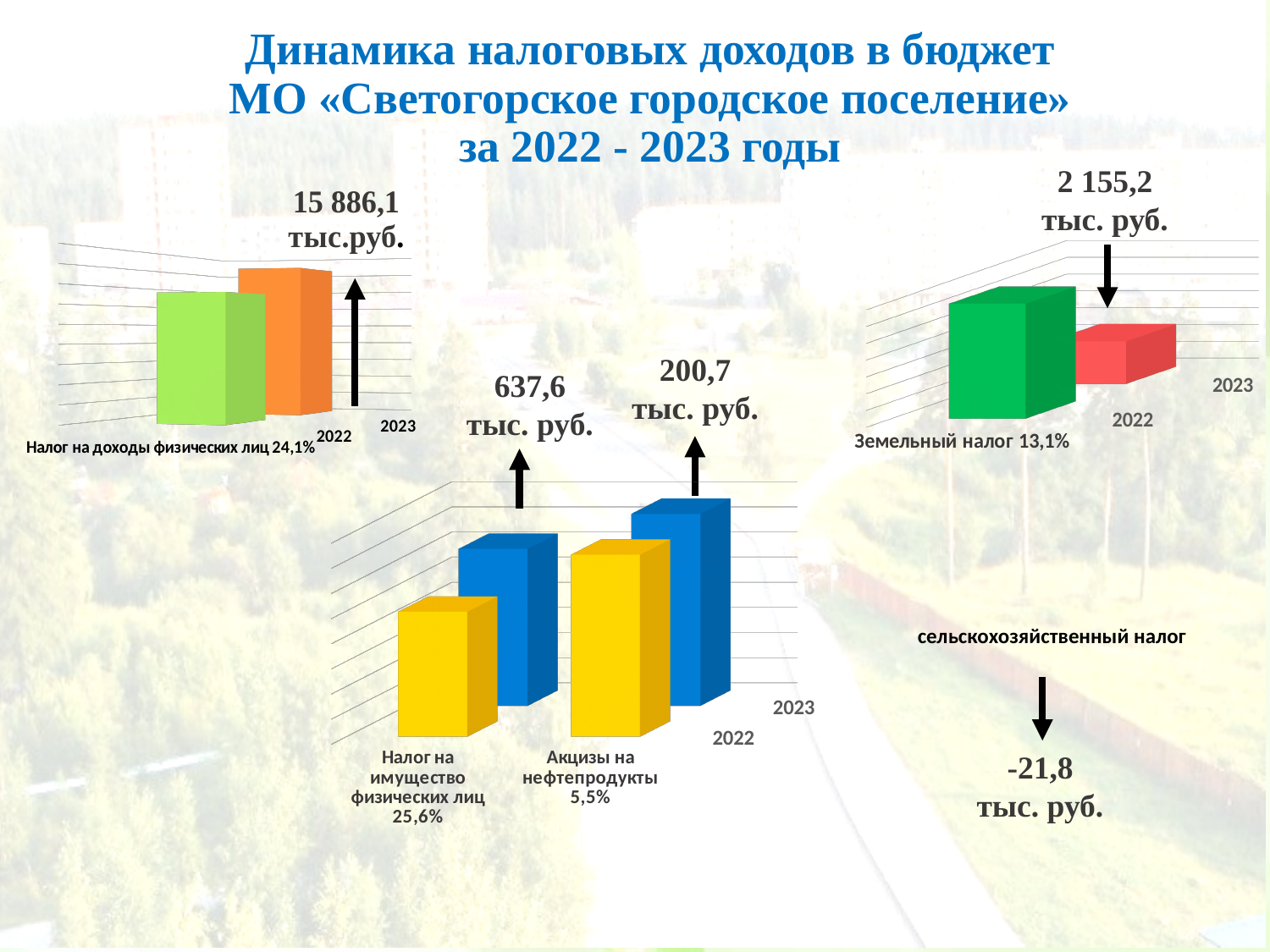
In the right chart (Земельный налог), which year has the taller bar, 2022 or 2023? 2022 What kind of chart is the chart labelled «Налог на доходы физических лиц 24,1%» on the left of the slide? bar chart In the right chart (Земельный налог), does the value rise or fall from 2022 to 2023? falls What value is printed with the downward arrow above the right chart (Земельный налог)? 2 155,2 тыс. руб. What colour is the 2023 bar in the left chart (Налог на доходы физических лиц)? orange In the left chart (Налог на доходы физических лиц), which year has the taller bar, 2022 or 2023? 2023 How many years are plotted in the middle chart? 2 How many tax categories are plotted in the middle chart (Налог на имущество физических лиц and Акцизы на нефтепродукты)? 2 In the left chart (Налог на доходы физических лиц), does the value rise or fall from 2022 to 2023? rises In the middle chart, for Налог на имущество физических лиц, which year has the taller bar, 2022 or 2023? 2023 What value is printed with the upward arrow above the left chart (Налог на доходы физических лиц)? 15 886,1 тыс.руб.